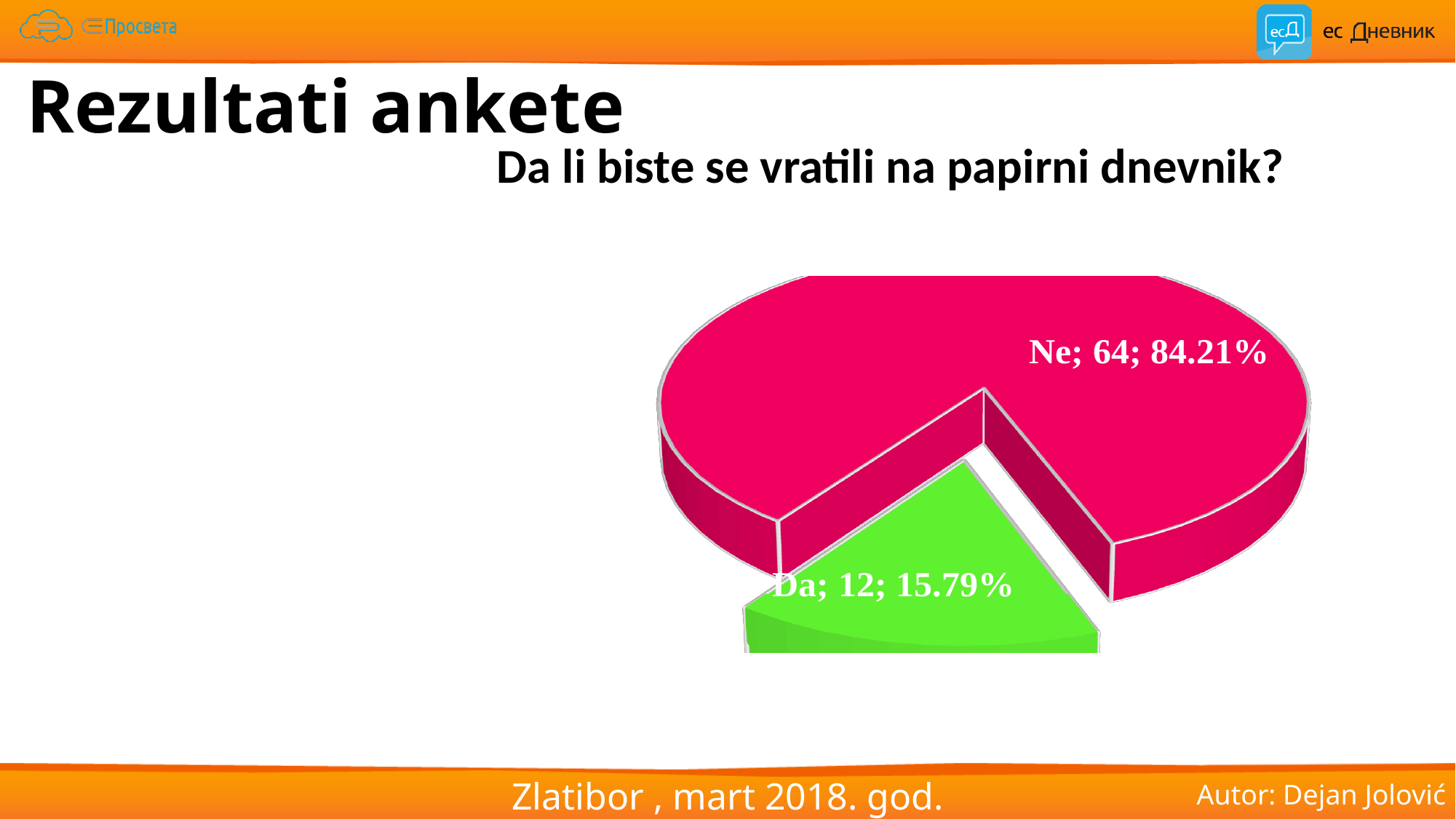
Which answer has the largest slice of the pie? Ne Which answer has the smallest slice of the pie? Da What kind of chart is shown on the slide? pie chart How many respondents answered "Ne"? 64 How many respondents answered "Da"? 12 What share of the pie does the "Ne" slice represent? 84.21% What colour is the "Da" slice of the pie chart? green What is the total number of responses shown in the pie chart? 76 How many slices does the pie chart have? 2 What share of the pie does the "Da" slice represent? 15.79% Which is larger, the number of "Da" responses or the number of "Ne" responses? Ne What is the difference between the number of "Ne" and "Da" responses? 52